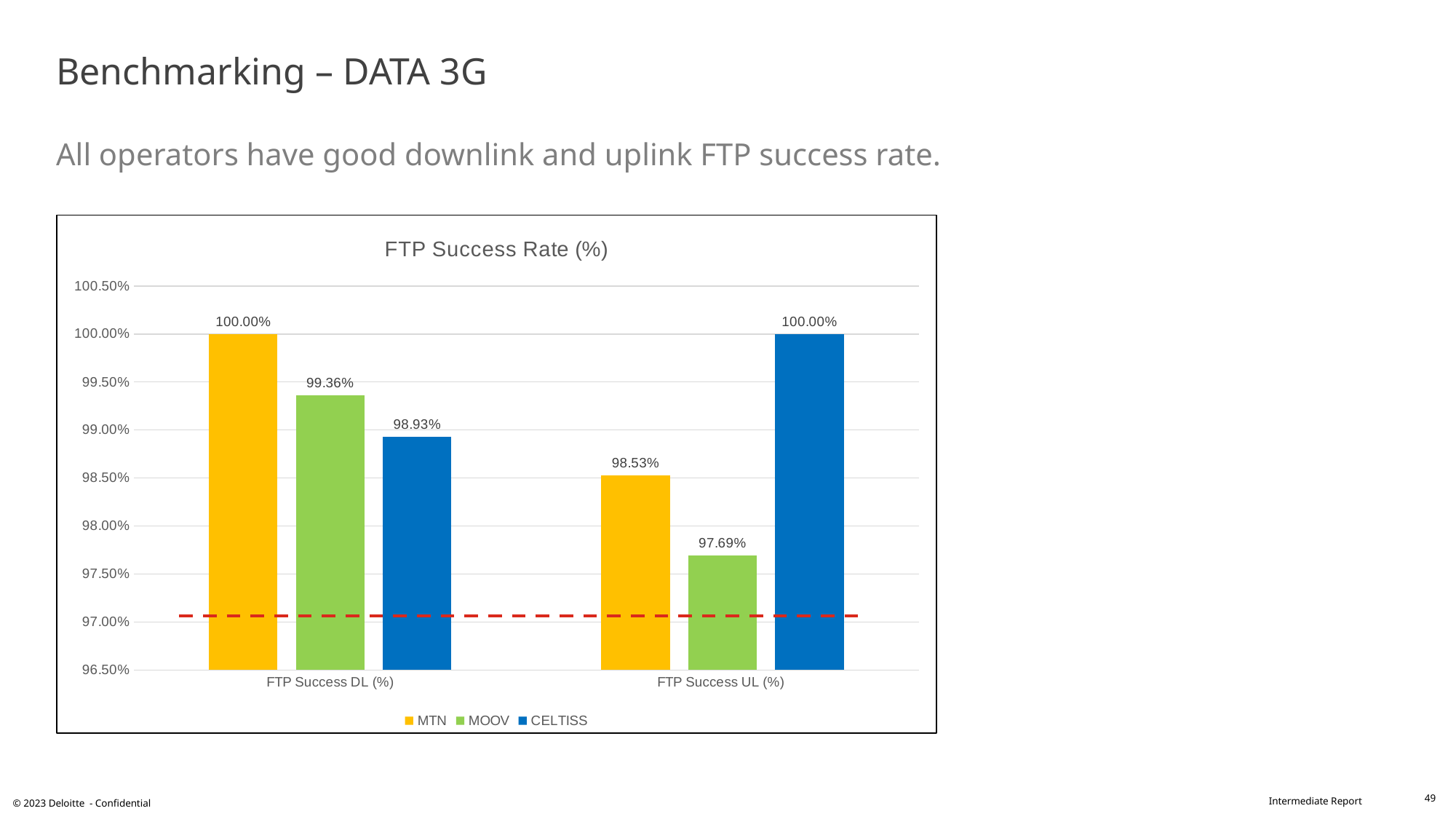
Which is larger: MOOV's FTP Success DL (%) or MOOV's FTP Success UL (%)? FTP Success DL (%) How many series does the legend list? 3 What is the FTP Success UL (%) value for MTN? 98.53% What is the FTP Success DL (%) value for MTN? 100.00% What is the FTP Success UL (%) value for MOOV? 97.69% Is the FTP Success UL (%) value for MOOV greater or less than 98.00%? less Which operator has the lowest FTP Success DL (%)? CELTISS What is the difference between MTN's and MOOV's FTP Success DL (%) values? 0.64% What is the FTP Success DL (%) value for CELTISS? 98.93% What kind of chart is shown on the slide? Bar chart What is the title of the chart? FTP Success Rate (%) Which operator has the highest FTP Success UL (%)? CELTISS